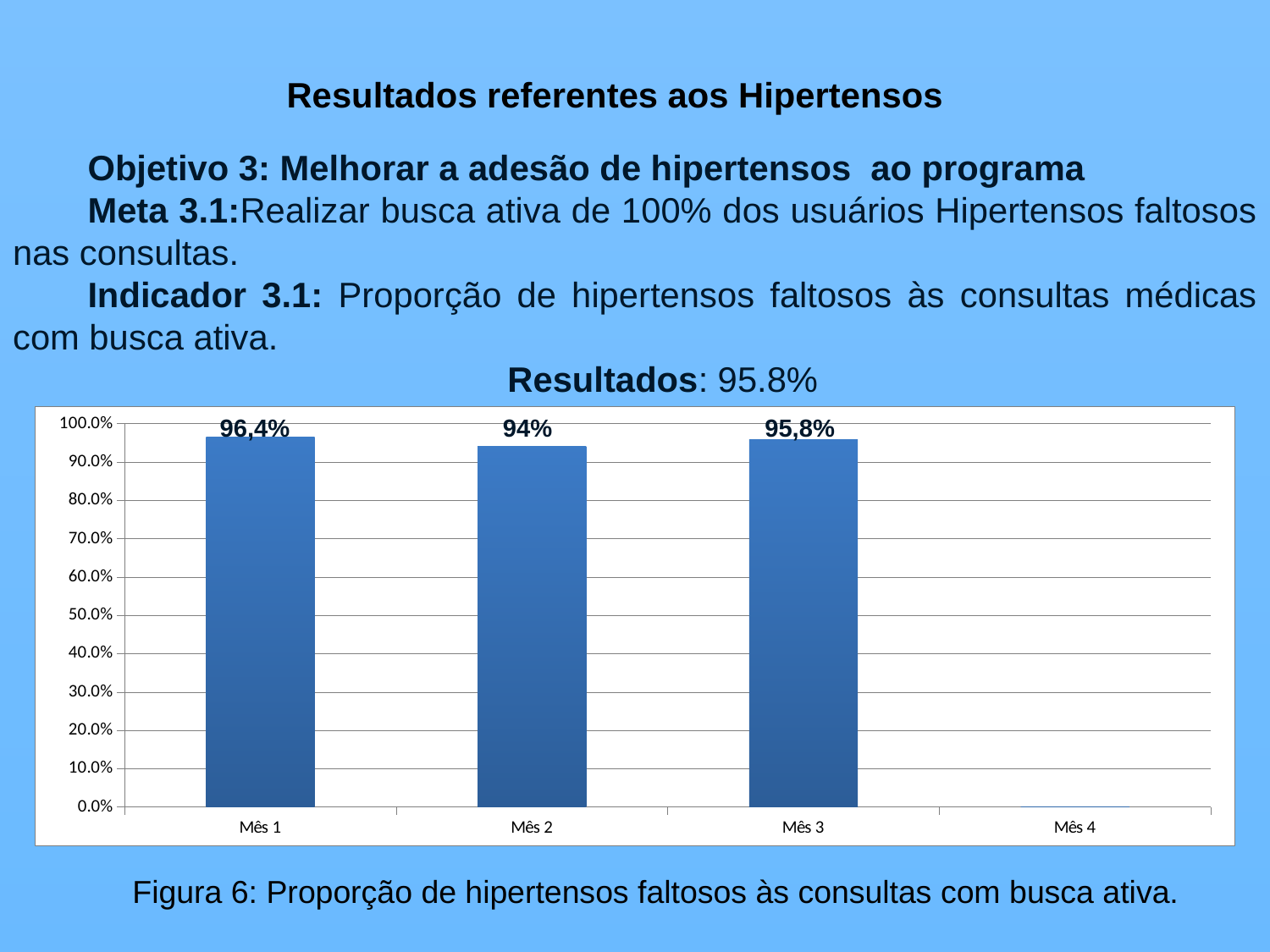
Is the value for Mês 2 greater or less than 90.0%? greater How many categories are shown on the x axis of the chart? 4 Which is larger, the value for Mês 2 or the value for Mês 3? Mês 3 What is the value shown for Mês 1? 96,4% What is the difference between the values for Mês 1 and Mês 2? 2,4 percentage points Which month has the highest value in the chart? Mês 1 What is the value shown for Mês 3? 95,8% Among the months with a plotted bar, which has the lowest value? Mês 2 What is the value shown for Mês 2? 94% What kind of chart is shown on the slide? Bar chart Does the value fall or rise from Mês 1 to Mês 2? Fall How many bars are actually plotted in the chart? 3